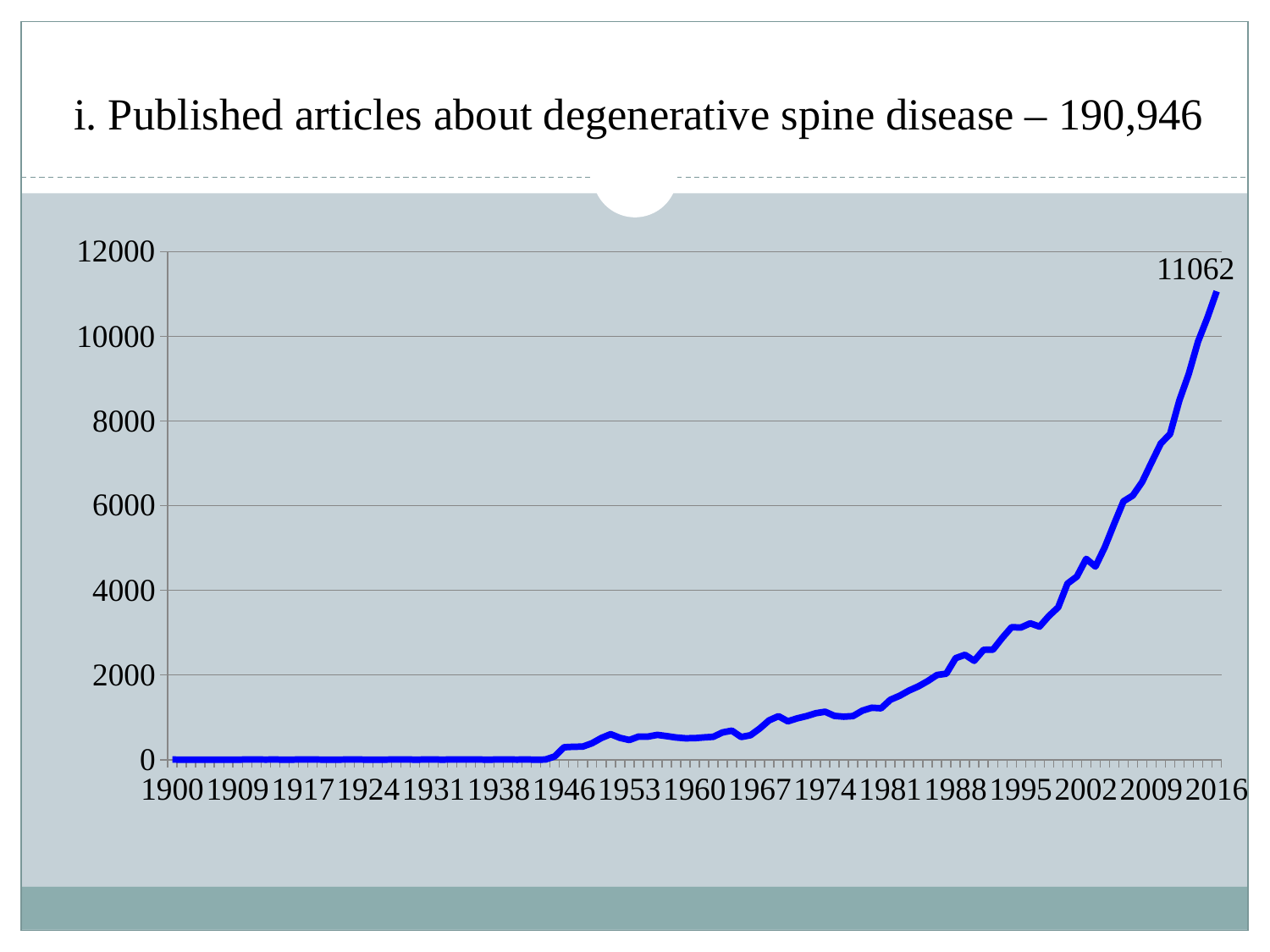
Is the value for 1988 greater or less than 4000? less Does the number of published articles generally rise or fall from 1900 to 2016? rise What is the title of the slide containing the chart? i. Published articles about degenerative spine disease – 190,946 Is the value for 2016 greater or less than 10000? greater What kind of chart is shown on the slide? line chart Which year has the larger value, 2009 or 1988? 2009 What is the number of published articles shown for 2016? 11062 In which year does the line reach its highest value? 2016 Is the value for 2002 greater or less than 6000? less What is the highest tick value shown on the vertical axis? 12000 Which year has the larger value, 1900 or 2016? 2016